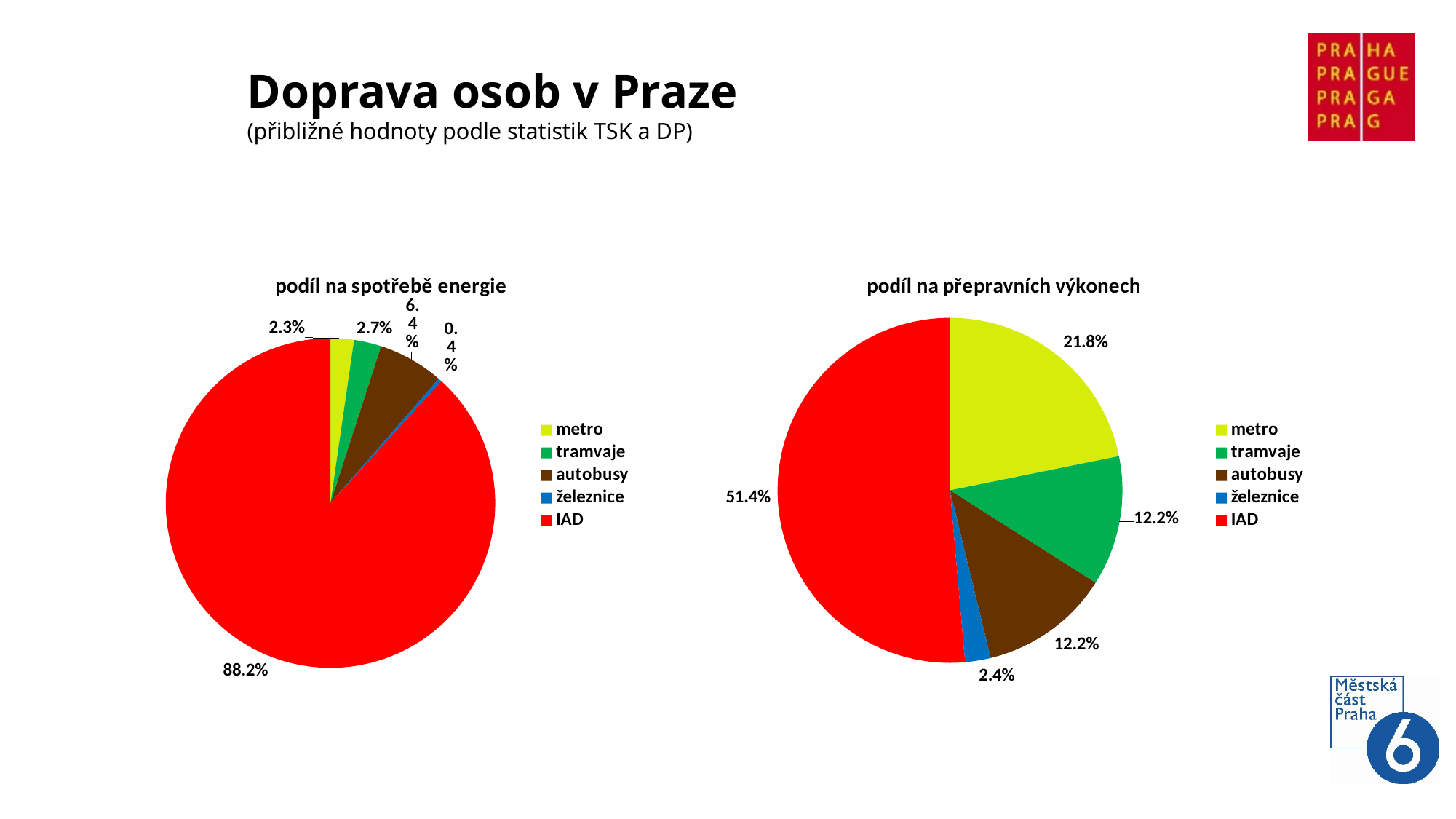
In the chart titled "podíl na přepravních výkonech", which category has the largest share? IAD What type of chart is the chart titled "podíl na spotřebě energie"? pie chart In the chart titled "podíl na spotřebě energie", which category has the smallest share? železnice In the chart titled "podíl na přepravních výkonech", what is the share for IAD? 51.4% In the chart titled "podíl na přepravních výkonech", what is the difference between the shares of metro and tramvaje? 9.6% In the chart titled "podíl na spotřebě energie", what is the share for IAD? 88.2% In the chart titled "podíl na spotřebě energie", what is the share for autobusy? 6.4% In the chart titled "podíl na přepravních výkonech", what is the share for metro? 21.8% How many categories does the legend of the chart titled "podíl na přepravních výkonech" list? 5 In the chart titled "podíl na spotřebě energie", which is larger, the share for tramvaje or the share for metro? tramvaje In the chart titled "podíl na spotřebě energie", what is the share for železnice? 0.4% In the chart titled "podíl na přepravních výkonech", what is the share for železnice? 2.4%